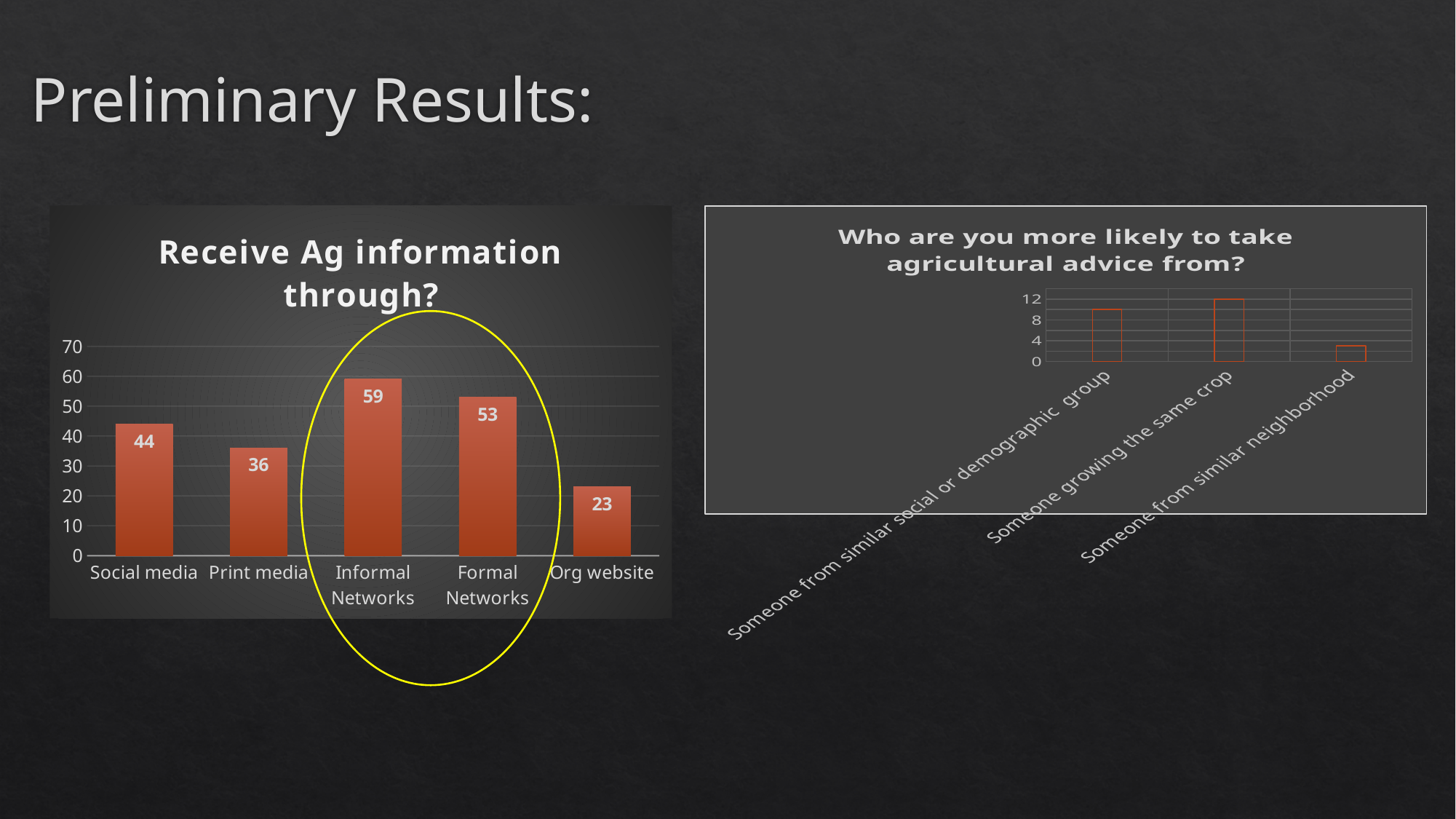
In the chart titled "Receive Ag information through?", which is larger, Social media or Print media? Social media In the chart titled "Receive Ag information through?", what is the value for Informal Networks? 59 In the chart titled "Receive Ag information through?", which two categories are circled in yellow? Informal Networks and Formal Networks In the chart titled "Who are you more likely to take agricultural advice from?", is the value for "Someone from similar social or demographic group" greater or less than 8? greater What kind of chart is the chart titled "Receive Ag information through?"? Bar chart In the chart titled "Receive Ag information through?", which category has the lowest value? Org website In the chart titled "Receive Ag information through?", how many categories are shown? 5 In the chart titled "Receive Ag information through?", which category has the highest value? Informal Networks In the chart titled "Receive Ag information through?", what is the difference between the values for Informal Networks and Formal Networks? 6 In the chart titled "Who are you more likely to take agricultural advice from?", which category has the highest value? Someone growing the same crop In the chart titled "Who are you more likely to take agricultural advice from?", is the value for "Someone from similar neighborhood" greater or less than 4? less In the chart titled "Receive Ag information through?", what is the value for Org website? 23